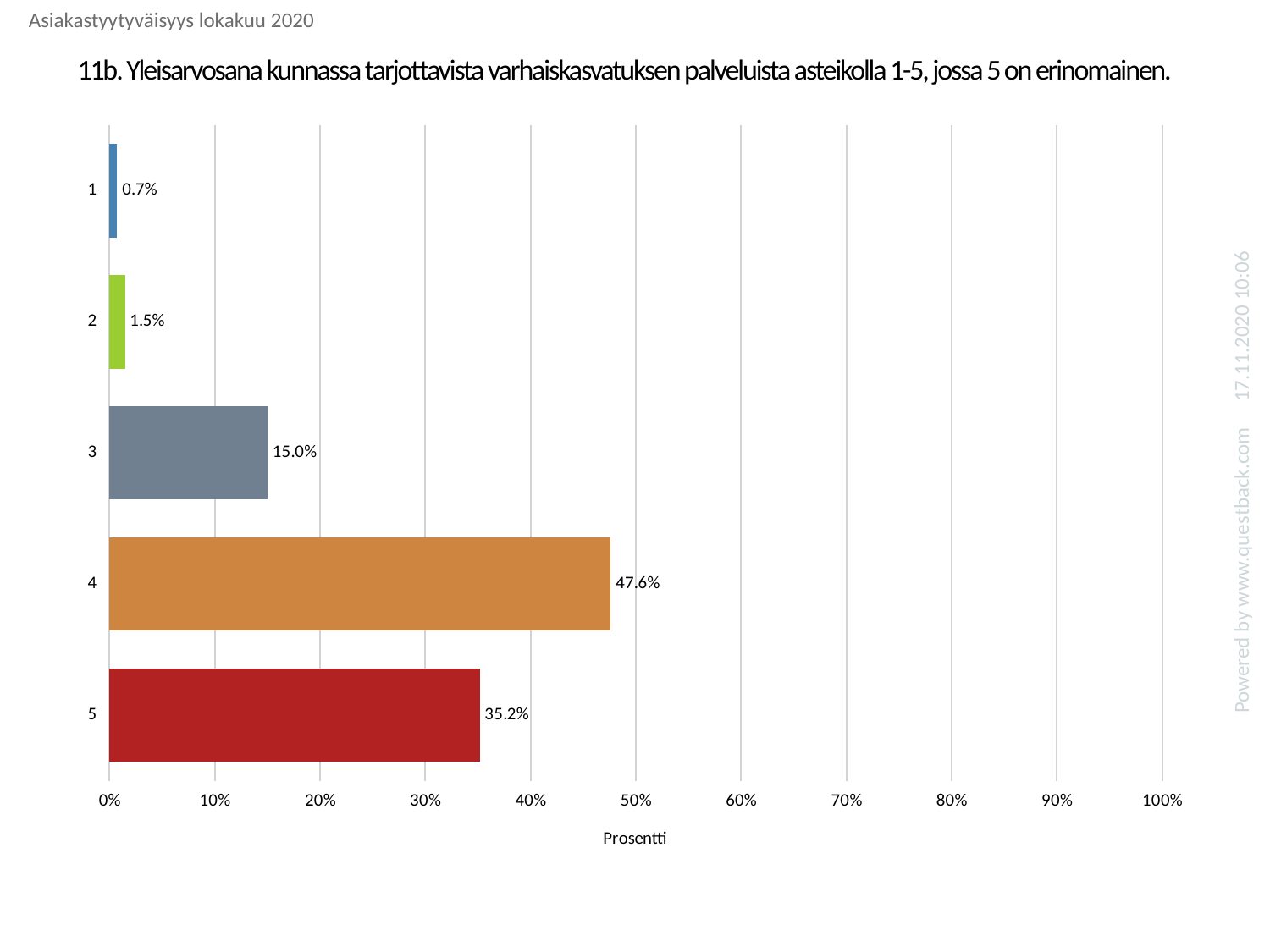
What kind of chart is shown on the slide? bar chart What is the value for category 5? 35.2% What is the value for category 4? 47.6% Is the value for category 4 greater or less than 40%? greater What is the value for category 3? 15.0% What is the value for category 1? 0.7% What is the difference between the values for category 4 and category 5? 12.4% What is the label of the horizontal axis? Prosentti Which category has the lowest value? 1 How many categories are shown in the chart? 5 Which is larger, the value for category 3 or the value for category 5? 5 Which category has the highest value? 4